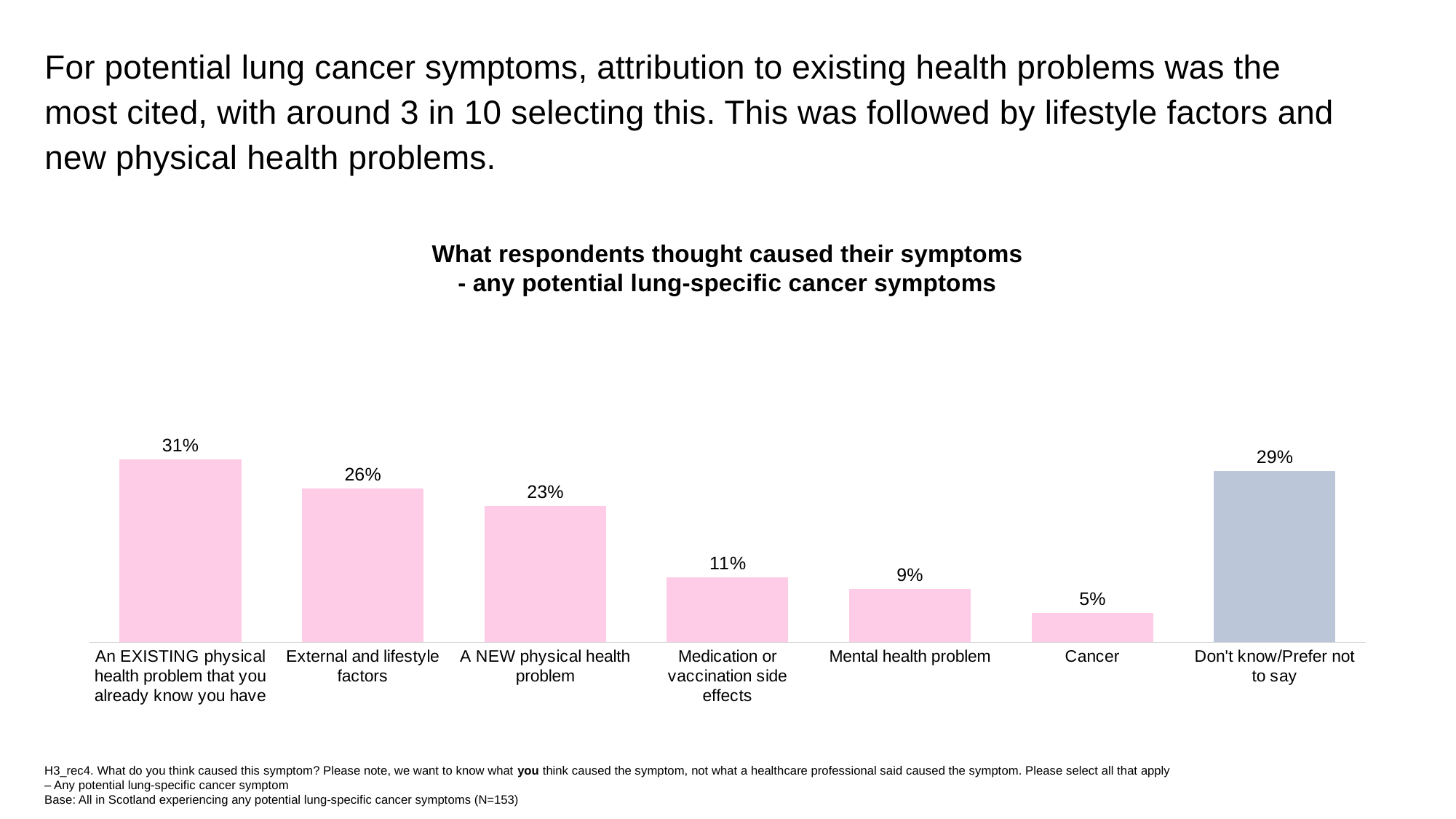
What percentage of respondents attributed their symptoms to an existing physical health problem that they already know they have? 31% Which is larger: the value for External and lifestyle factors or the value for Don't know/Prefer not to say? Don't know/Prefer not to say Which category has the lowest value? Cancer What value is shown for Don't know/Prefer not to say? 29% How many categories are shown in the chart? 7 What is the difference between the values for A NEW physical health problem and Mental health problem? 14 percentage points Which category has the highest value? An EXISTING physical health problem that you already know you have What percentage is shown for Medication or vaccination side effects? 11% What kind of chart is shown on the slide? Bar chart Which bar is shown in a different colour (grey-blue) from the others? Don't know/Prefer not to say What value is shown for External and lifestyle factors? 26% What is the title of the chart? What respondents thought caused their symptoms - any potential lung-specific cancer symptoms